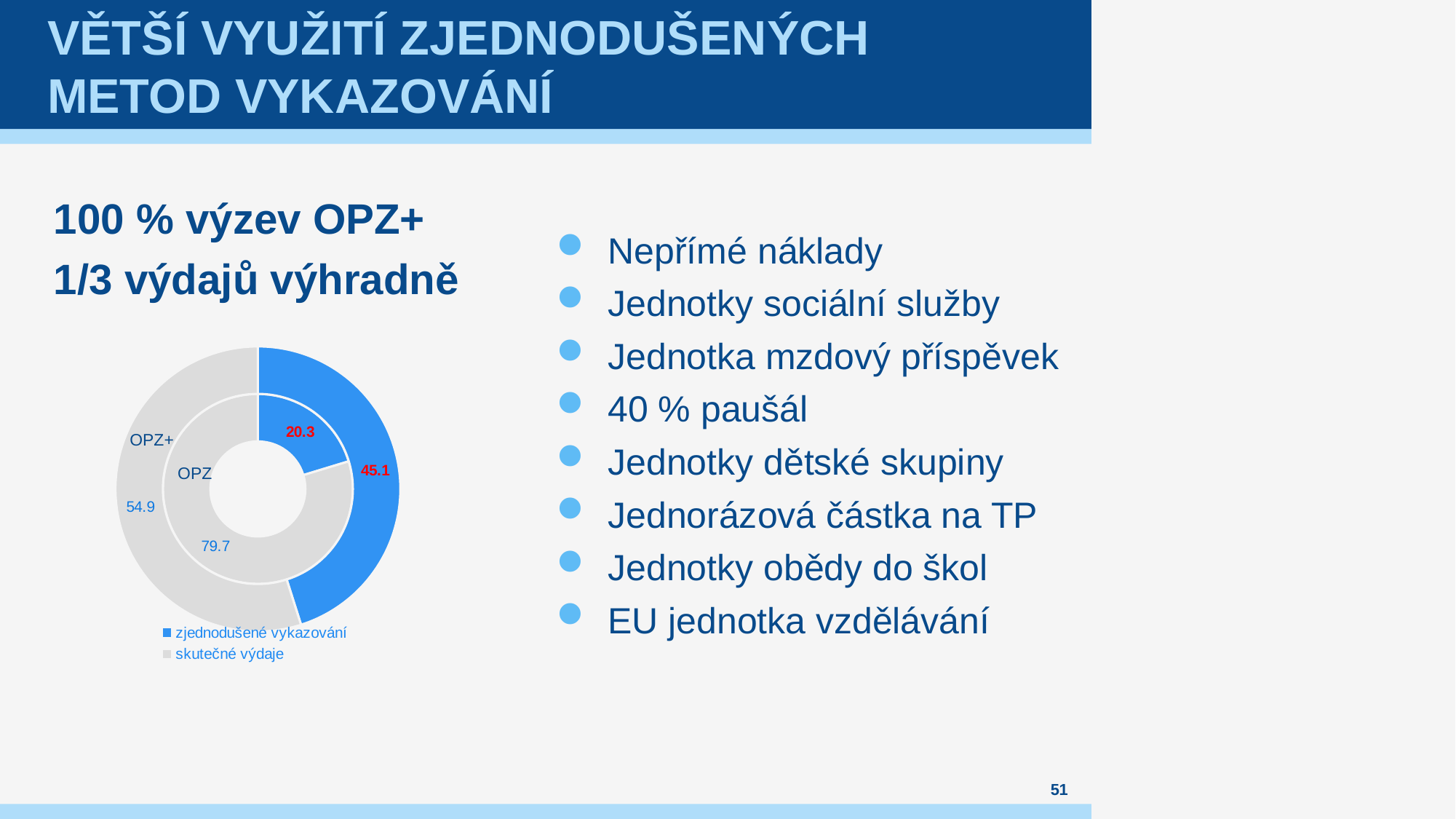
What kind of chart is shown on the slide? doughnut chart What is the value for skutečné výdaje in the OPZ ring? 79.7 What is the value for skutečné výdaje in the OPZ+ ring? 54.9 How many entries does the chart legend list? 2 What is the value for zjednodušené vykazování in the OPZ+ ring? 45.1 What is the value for zjednodušené vykazování in the OPZ ring? 20.3 Which is larger in the OPZ ring: zjednodušené vykazování or skutečné výdaje? skutečné výdaje What is the difference between skutečné výdaje and zjednodušené vykazování in the OPZ+ ring? 9.8 Which ring has the larger value for zjednodušené vykazování, OPZ or OPZ+? OPZ+ What is the difference between the zjednodušené vykazování values for OPZ+ and OPZ? 24.8 Which colour represents zjednodušené vykazování in the chart? blue Which ring of the doughnut chart is labelled OPZ, the inner or the outer? inner